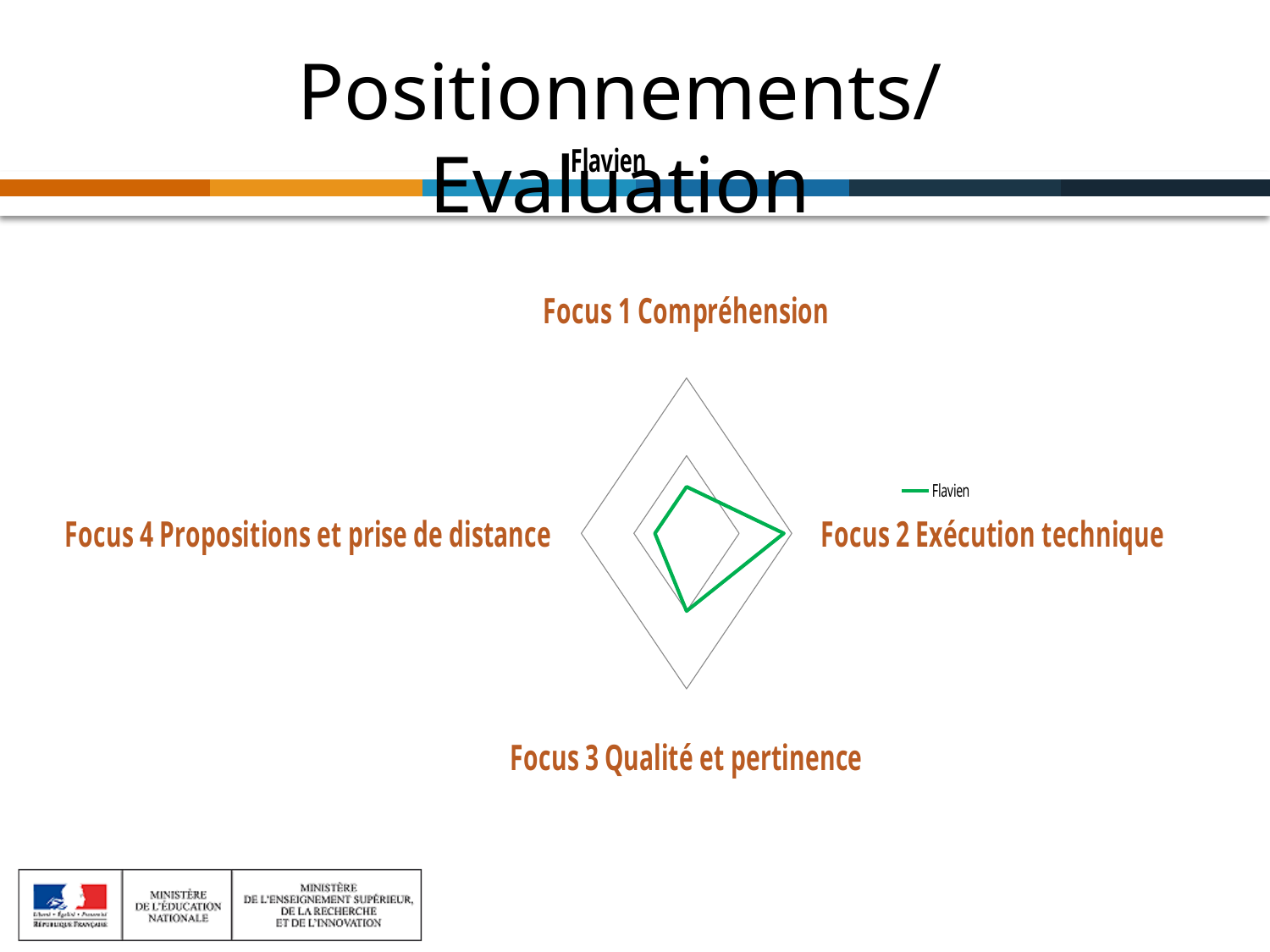
Which category has the highest value on the radar chart? Focus 2 Exécution technique How many categories (axes) does the radar chart have? 4 Which is larger on the radar chart, the value for Focus 2 Exécution technique or the value for Focus 1 Compréhension? Focus 2 Exécution technique Which is larger on the radar chart, the value for Focus 3 Qualité et pertinence or the value for Focus 4 Propositions et prise de distance? Focus 3 Qualité et pertinence Which is larger on the radar chart, the value for Focus 2 Exécution technique or the value for Focus 3 Qualité et pertinence? Focus 2 Exécution technique What is the name of the series shown in the legend of the radar chart? Flavien What kind of chart is shown on the slide? Radar chart What colour is the line plotted for Flavien on the radar chart? Green How many series does the legend of the radar chart list? 1